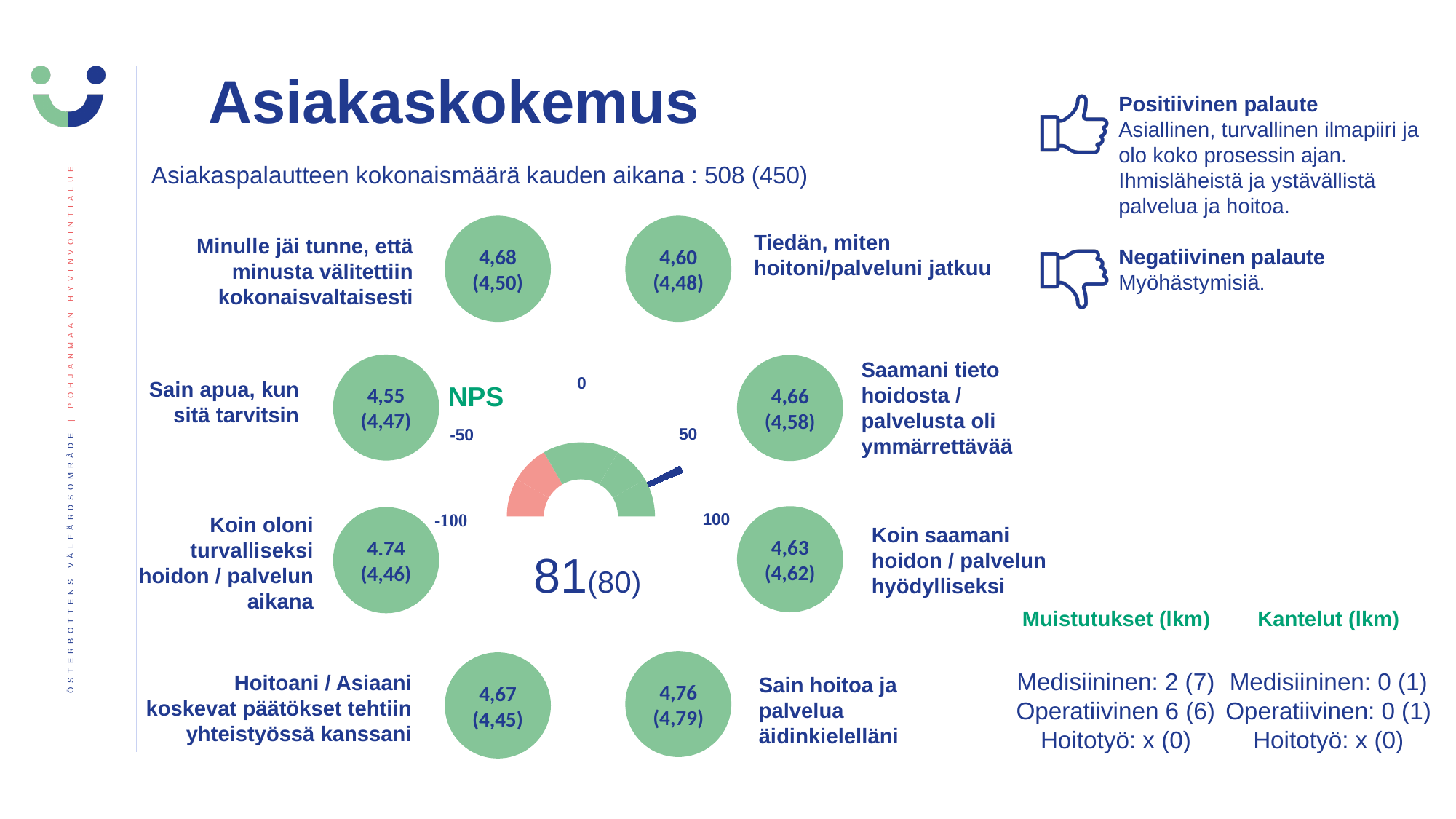
Which statement has the highest score in the green circles? Sain hoitoa ja palvelua äidinkielelläni What is the score shown in the green circle for 'Sain apua, kun sitä tarvitsin'? 4,55 (4,47) What kind of chart is the NPS chart in the centre of the slide? gauge chart What colour is the segment at the low (-100) end of the NPS gauge? red Is the NPS value shown on the gauge greater or less than 50? greater What NPS value is printed below the gauge chart? 81 What is the highest tick label on the NPS gauge? 100 How many green score circles surround the NPS gauge? 8 What is the difference between the current NPS value (81) and the value in parentheses (80)? 1 What is the lowest tick label on the NPS gauge? -100 What value is shown in parentheses next to the NPS value of 81? 80 How many tick labels are printed around the NPS gauge? 5